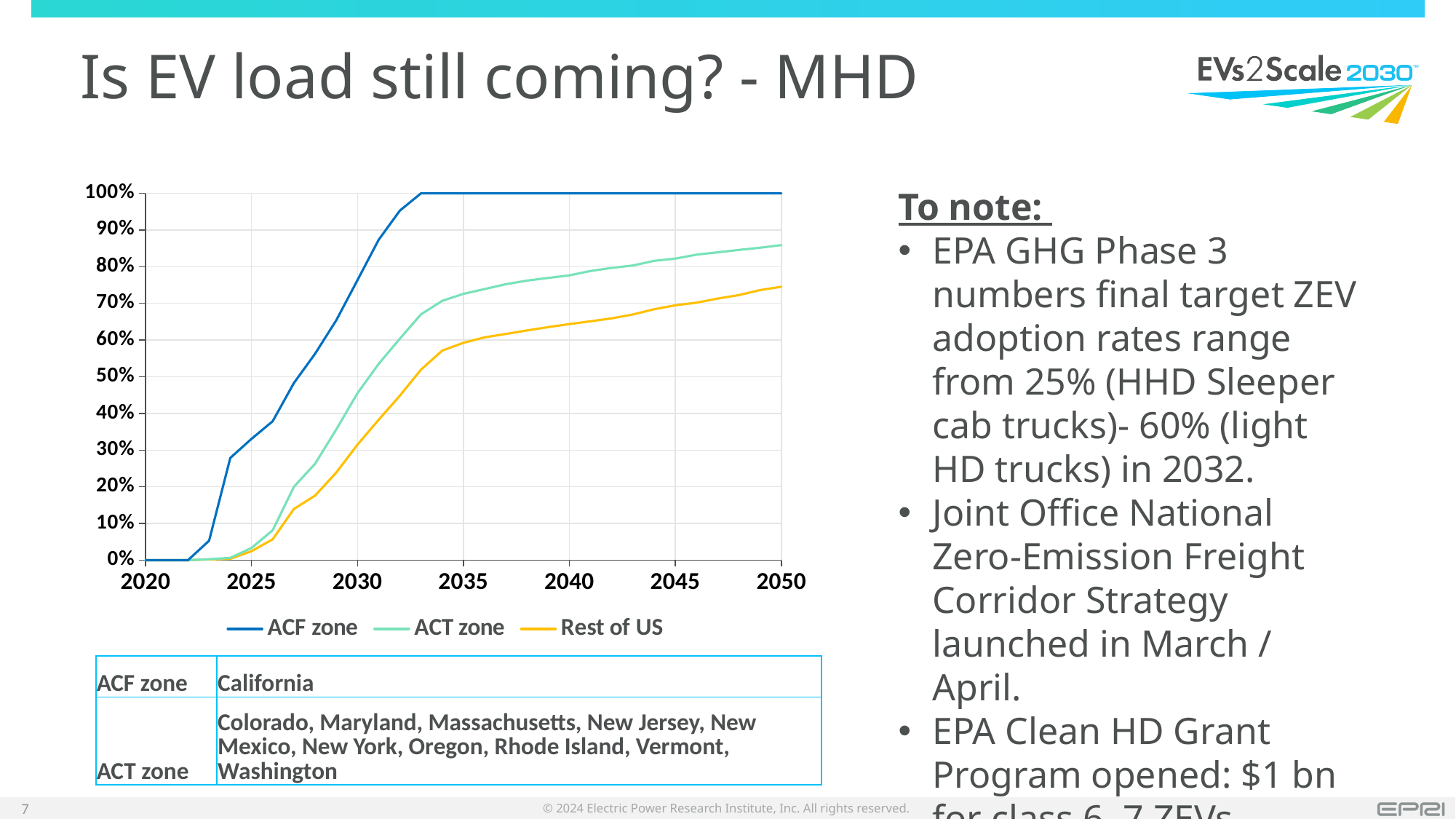
Is the value for Rest of US in 2050 greater or less than 70%? greater What is the value of the ACF zone line in 2020? 0% Is the value for ACF zone in 2030 greater or less than 60%? greater How many series does the chart legend list? 3 Do the values for Rest of US rise or fall from 2020 to 2050? rise What kind of chart is shown on the slide? line chart What is the value of the ACF zone line in 2050? 100% Which series has the lowest value in 2050? Rest of US In 2050, which is larger: the ACT zone value or the Rest of US value? ACT zone Is the value for ACT zone in 2050 greater or less than 80%? greater Which series has the highest value in 2050? ACF zone What are the three series named in the chart legend? ACF zone, ACT zone, Rest of US